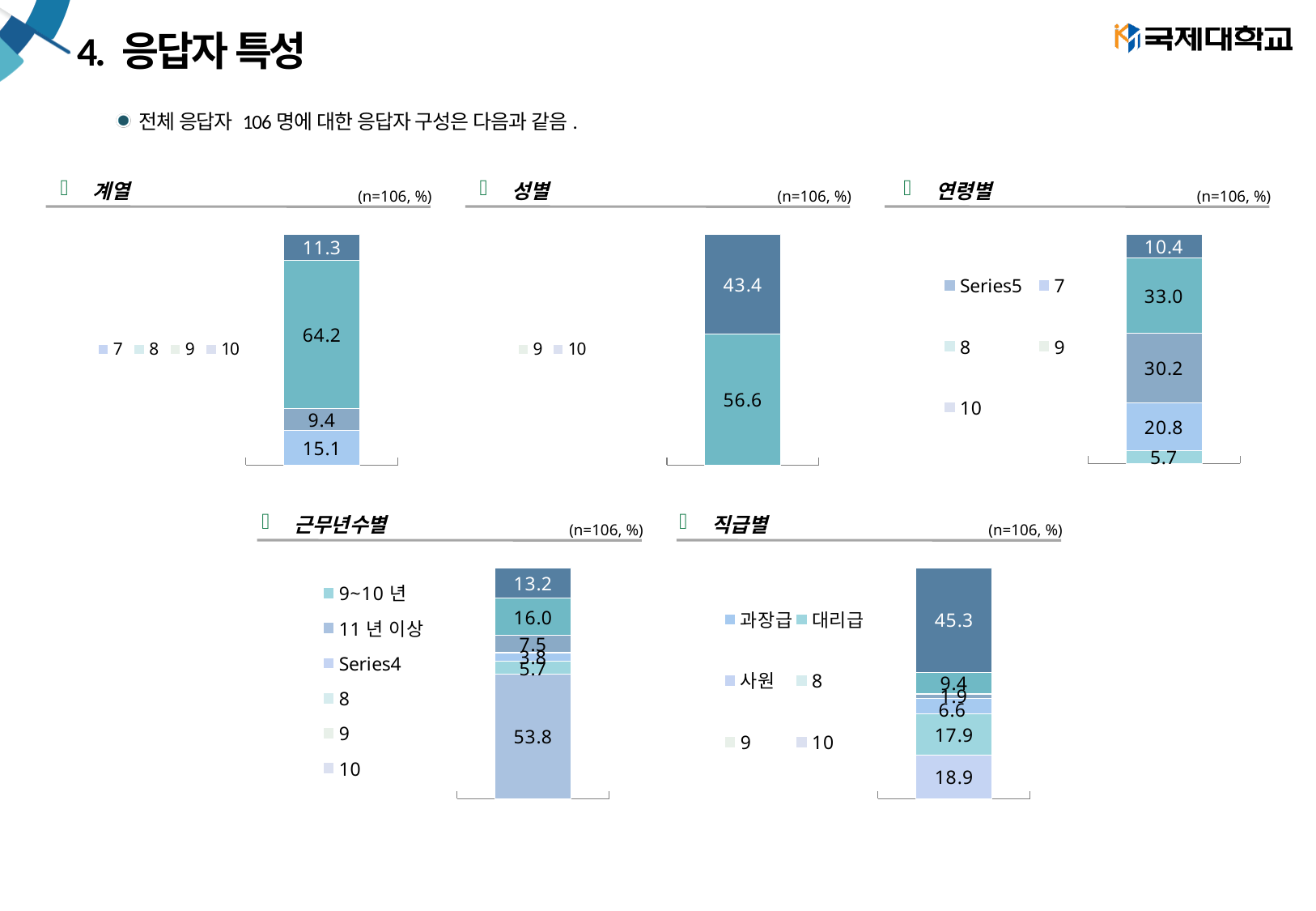
What kind of chart is the 직급별 chart? Stacked bar chart In the 성별 chart, what is the difference between the two segments of the bar? 13.2 In the 직급별 chart, what is the smallest segment value in the stacked bar? 1.9 In the 연령별 chart, what is the smallest segment value? 5.7 In the 계열 chart, what is the largest segment value in the stacked bar? 64.2 In the 연령별 chart, how many segments make up the stacked bar? 5 In the 근무년수별 chart, what is the largest segment value in the stacked bar? 53.8 In the 계열 chart, what is the total of all segments in the stacked bar? 100.0 In the 연령별 chart, which is larger, the segment labelled 33.0 or the segment labelled 30.2? 33.0 In the 성별 chart, what is the value of the bottom segment of the stacked bar? 56.6 In the 계열 chart, what is the smallest segment value in the stacked bar? 9.4 In the 성별 chart, what is the value of the top segment of the stacked bar? 43.4